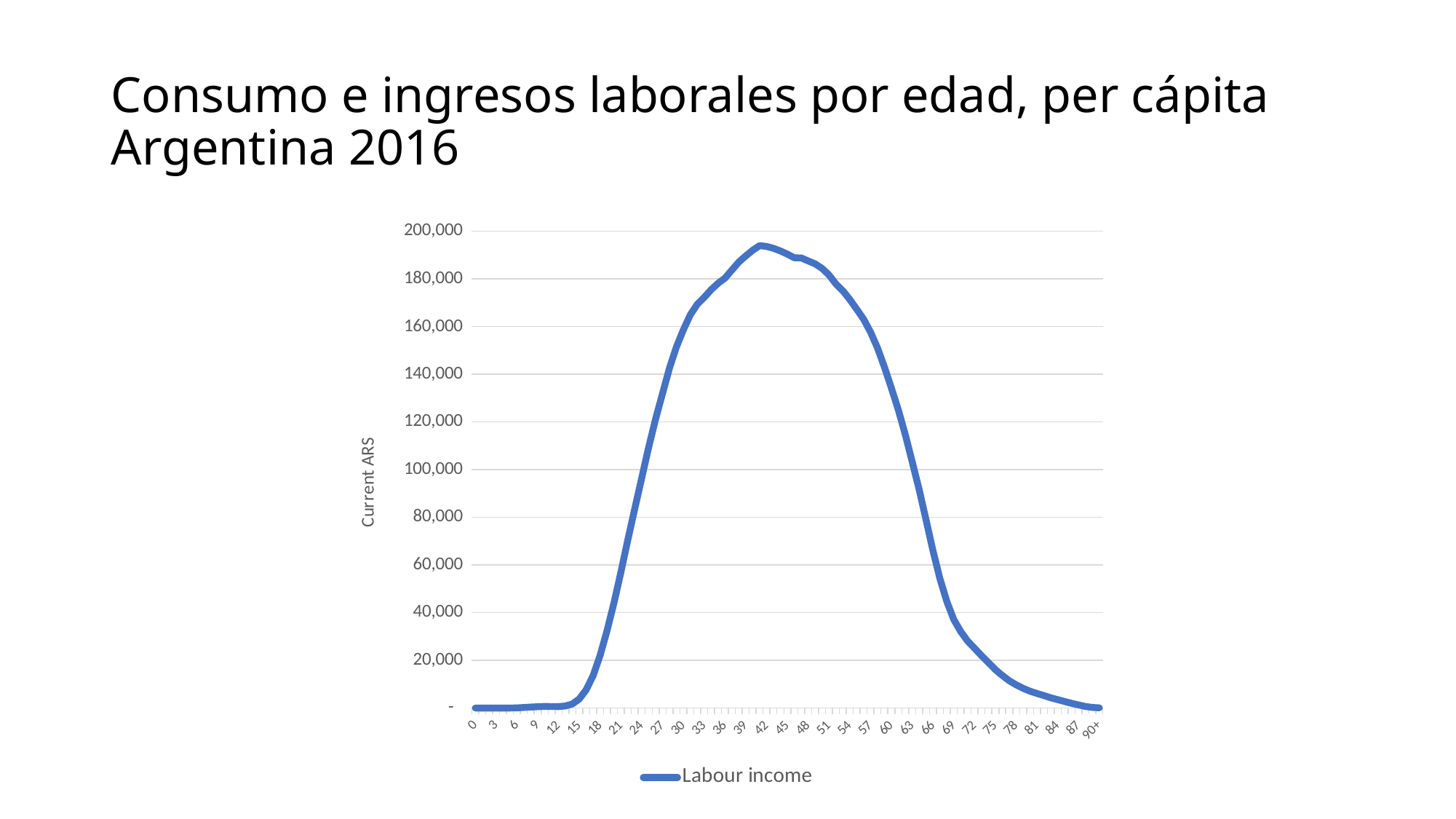
Is the value for age 42 greater or less than 180,000? greater Does labour income rise or fall between age 42 and age 90+? fall Is the value for age 57 greater or less than 140,000? greater How many series does the legend list? 1 Is the value for age 27 greater or less than 140,000? less What kind of chart is shown on the slide? line chart What is the name of the series shown in the legend? Labour income What is the title of the vertical axis? Current ARS